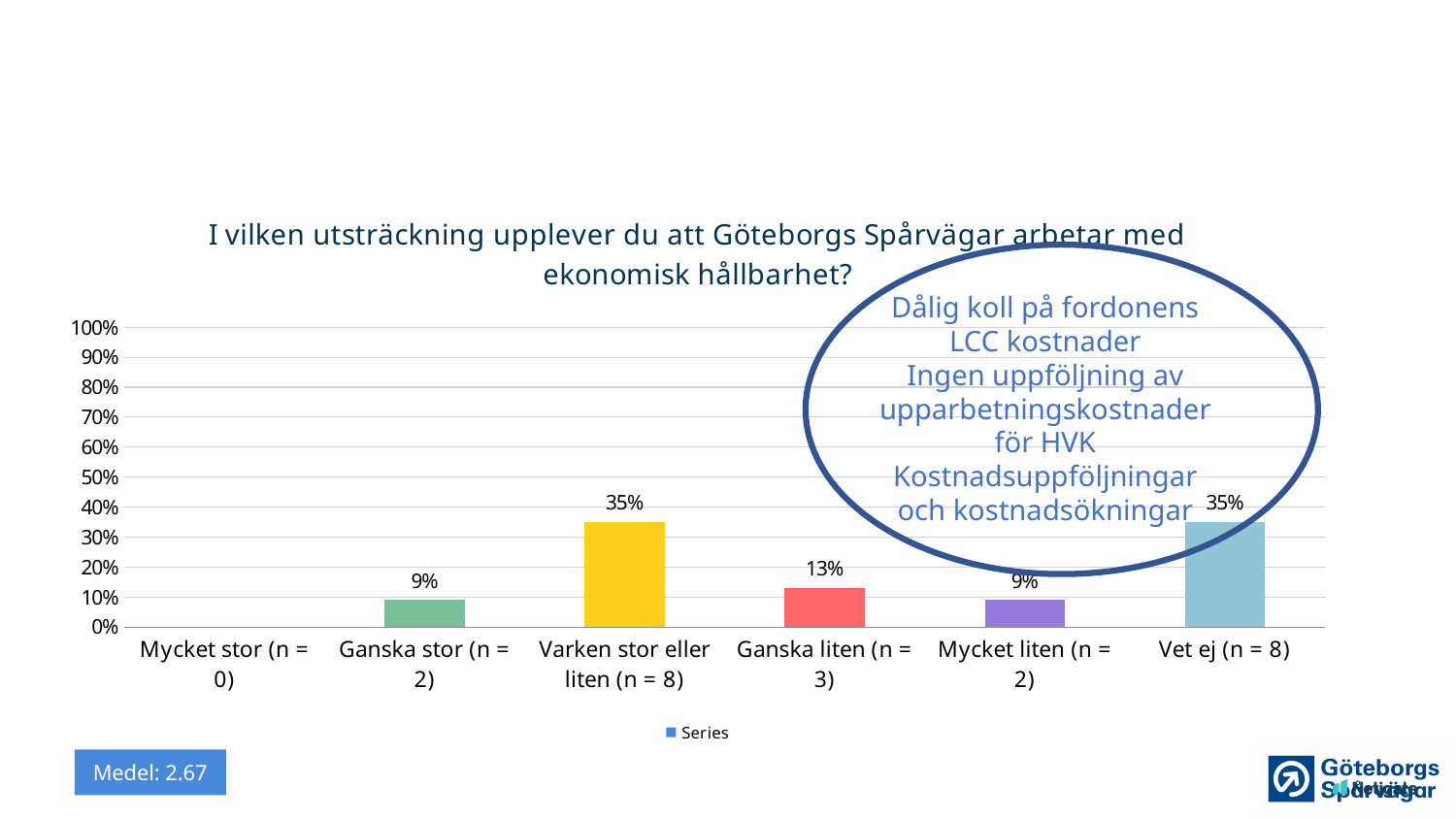
What kind of chart is shown on the slide? bar chart What is the value for Ganska stor (n = 2)? 9% What is the value for Mycket liten (n = 2)? 9% What is the value for Varken stor eller liten (n = 8)? 35% Which is larger, the value for Ganska liten (n = 3) or the value for Mycket liten (n = 2)? Ganska liten (n = 3) What is the value for Vet ej (n = 8)? 35% How many categories are shown on the x axis? 6 How many series does the legend list? 1 Is the value for Vet ej (n = 8) greater or less than 30%? greater Which category has the lowest value? Mycket stor (n = 0) What is the difference between the values for Varken stor eller liten (n = 8) and Ganska liten (n = 3)? 22% What is the value for Ganska liten (n = 3)? 13%